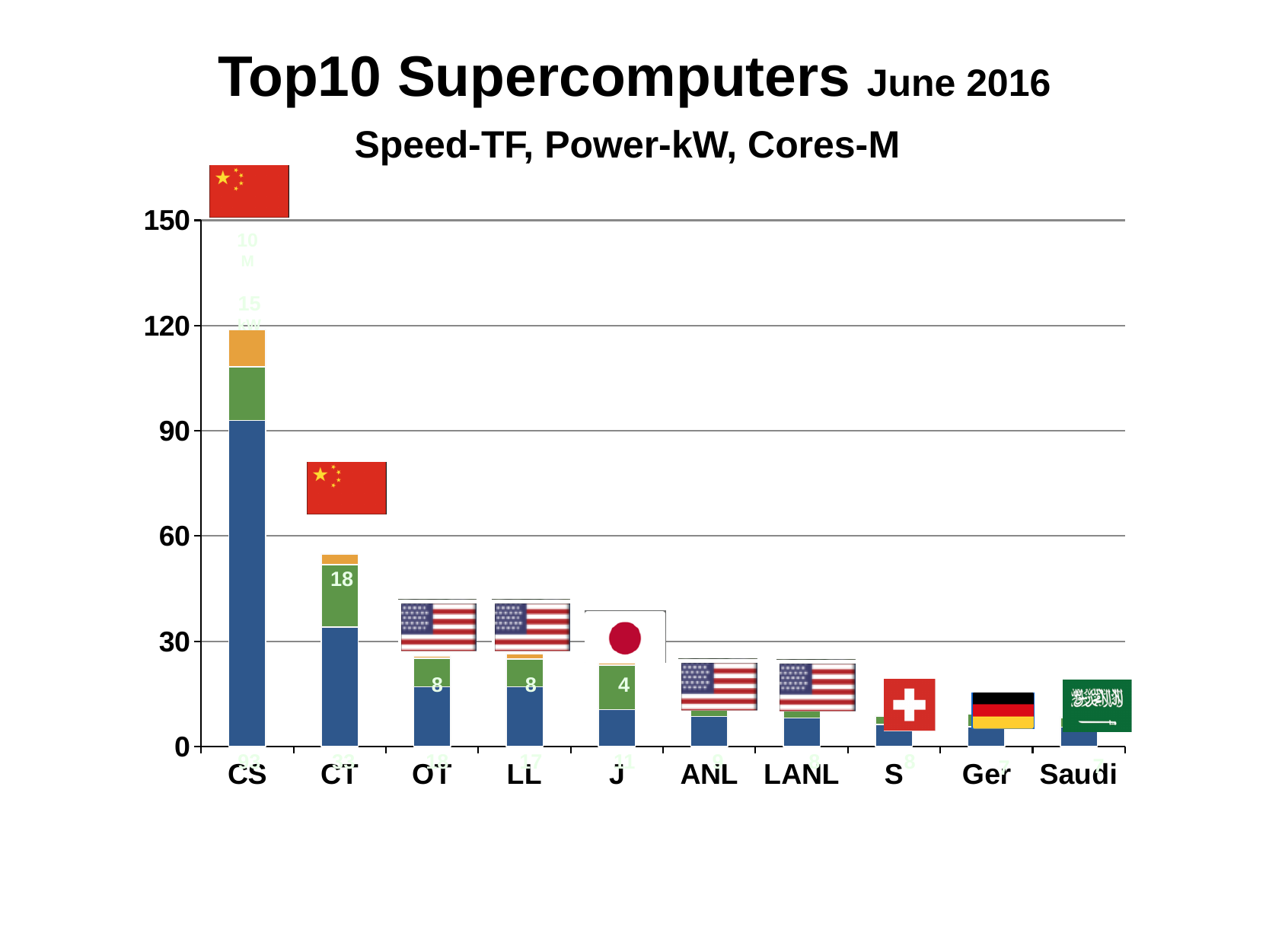
Which category has the tallest bar in the chart? CS How many categories are shown along the x axis of the chart? 10 What is the value printed on the green segment of the CT bar? 18 Which bar is taller overall, CS or CT? CS What is the difference between the green segment values of CT and J? 14 What kind of chart is shown on the slide? bar chart Do the bar heights generally rise or fall from left to right along the x axis? fall Is the total height of the CT bar greater or less than 60? less Is the total height of the CS bar greater or less than 90? greater What is the value printed on the green segment of the OT bar? 8 What is the title of the chart on the slide? Top10 Supercomputers June 2016 What is the value printed on the green segment of the J bar? 4